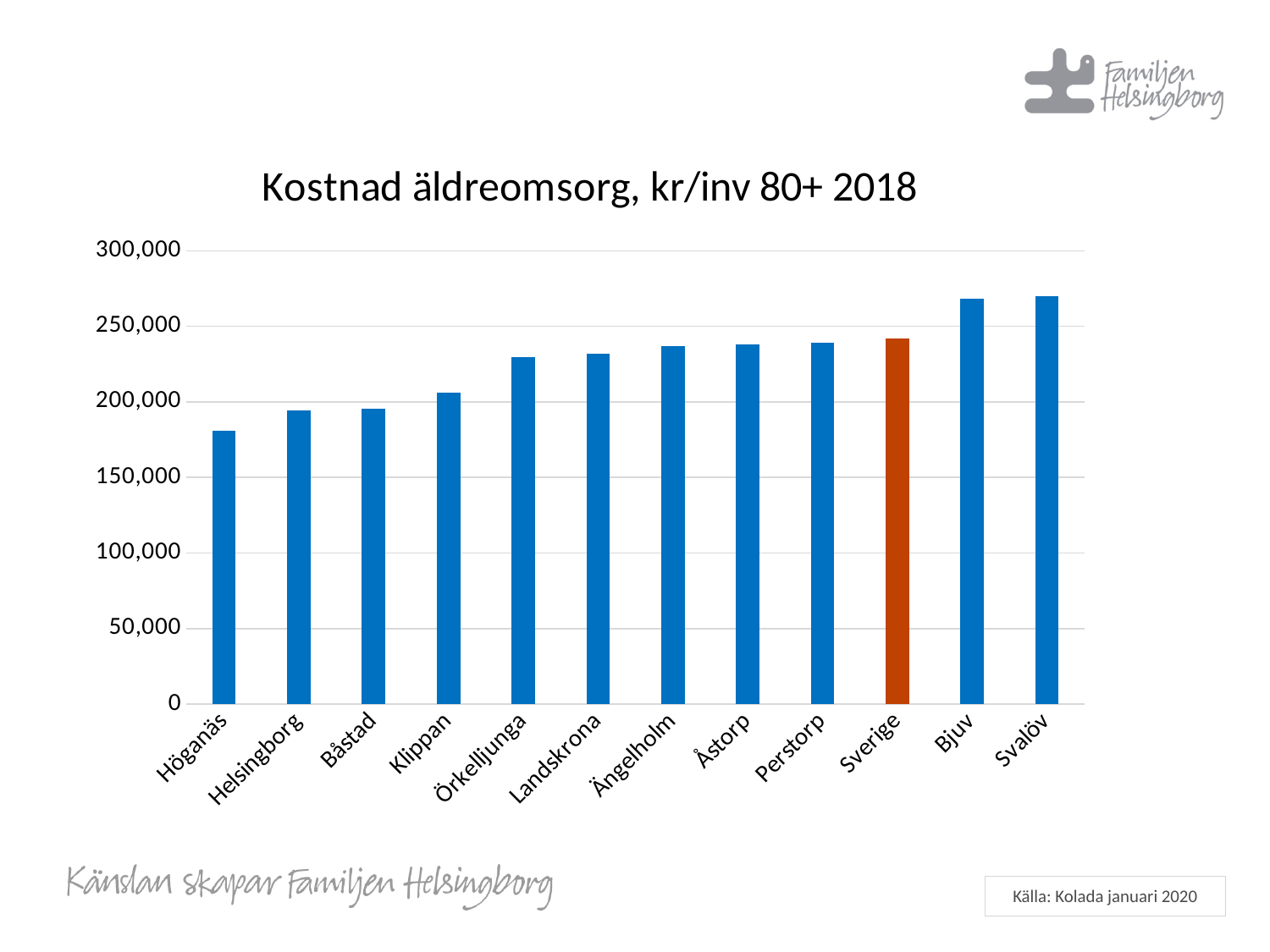
Which category's bar is shown in a different colour (orange) from the others? Sverige What kind of chart is shown on the slide? Bar chart Is the value for Klippan greater or less than 200,000? greater Is the value for Bjuv greater or less than 250,000? greater How many categories are shown on the x axis of the chart? 12 Is the value for Helsingborg greater or less than 200,000? less Which category has the lowest value in the chart? Höganäs Which has a larger value, Klippan or Höganäs? Klippan Which has a larger value, Bjuv or Landskrona? Bjuv Do the values generally rise or fall from left to right along the x axis? Rise